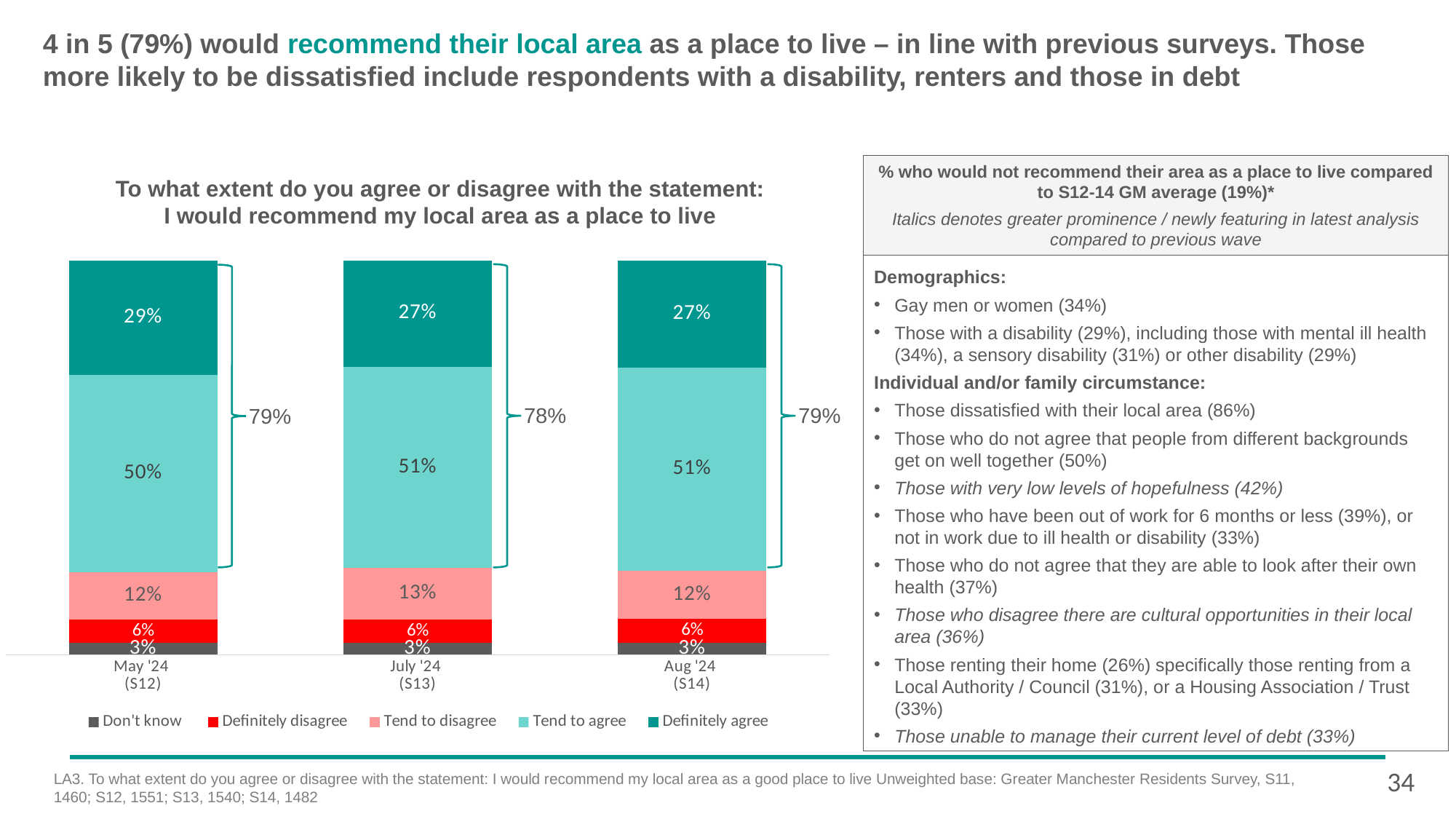
What is the difference between the 'Tend to agree' percentage in Aug '24 (S14) and in May '24 (S12)? 1% What is the combined 'agree' percentage shown by the bracket for July '24 (S13)? 78% What percentage of respondents in May '24 (S12) said they 'Definitely agree' that they would recommend their local area as a place to live? 29% Is the 'Definitely agree' percentage larger in May '24 (S12) or in Aug '24 (S14)? May '24 (S12) What percentage of respondents in Aug '24 (S14) said they 'Tend to disagree'? 12% How many survey waves are shown on the x axis of the chart? 3 Which survey wave has the highest 'Definitely agree' percentage? May '24 (S12) How many response categories does the chart legend list? 5 What percentage of respondents in July '24 (S13) said they 'Tend to agree'? 51% What type of chart is used to show the responses? Stacked bar chart Which legend entry is shown in red? Definitely disagree Which survey wave has the highest 'Tend to disagree' percentage? July '24 (S13)